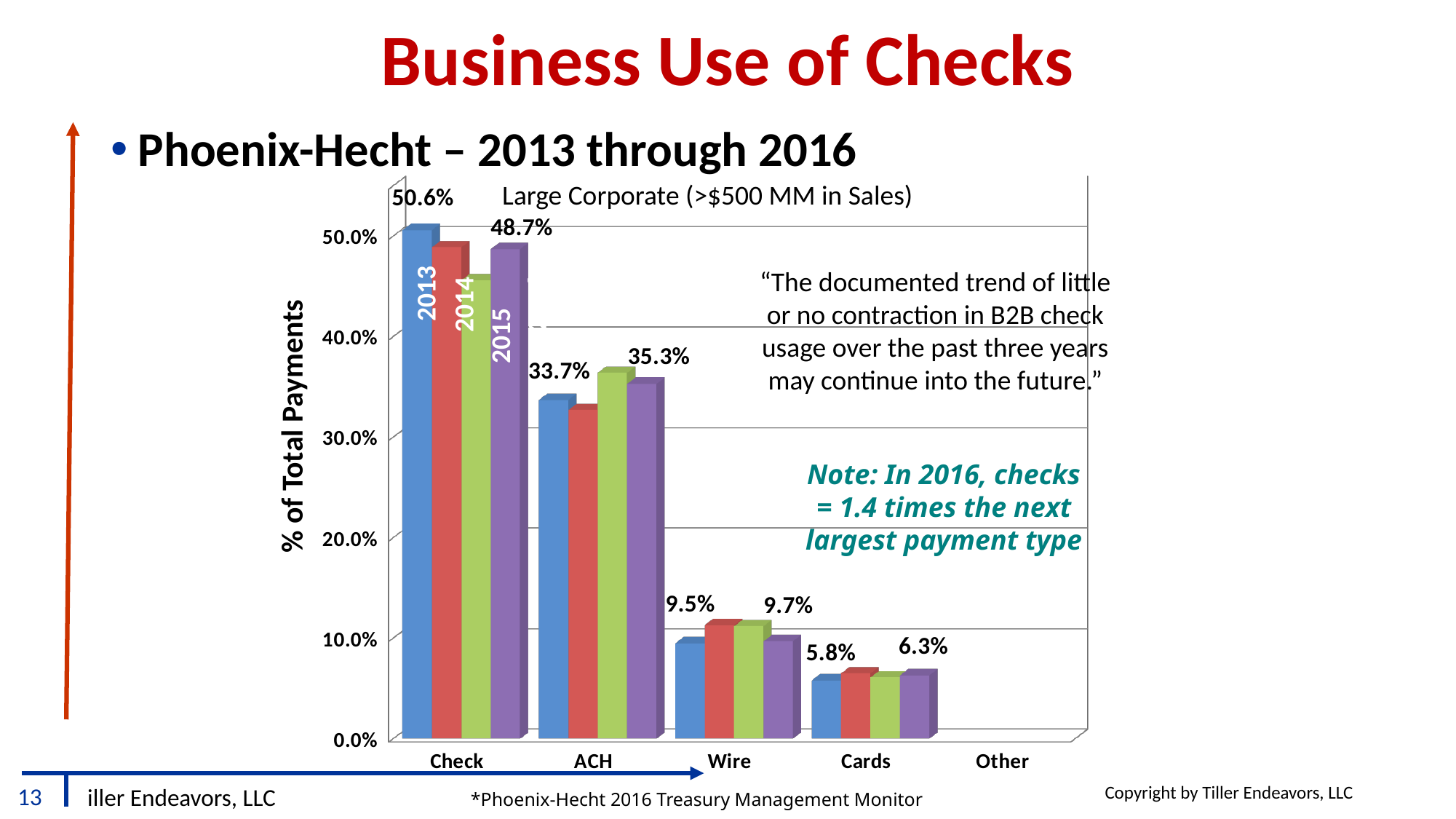
What is the value labeled on the rightmost bar for Check? 48.7% What is the value labeled on the leftmost (2013) bar for Check? 50.6% What is the difference between the leftmost Check bar (50.6%) and the rightmost Check bar (48.7%)? 1.9 percentage points What kind of chart is shown on the slide? bar chart Which is larger, the leftmost (2013) bar for Check or the leftmost (2013) bar for ACH? Check What is the value labeled on the rightmost bar for ACH? 35.3% What is the title printed above the chart? Large Corporate (>$500 MM in Sales) Is the value of the leftmost Wire bar greater or less than 20%? less How many payment-type categories are shown on the x axis? 5 What is the label on the vertical axis of the chart? % of Total Payments What is the value labeled on the leftmost (2013) bar for Cards? 5.8% Which payment type has the tallest bars in the chart? Check